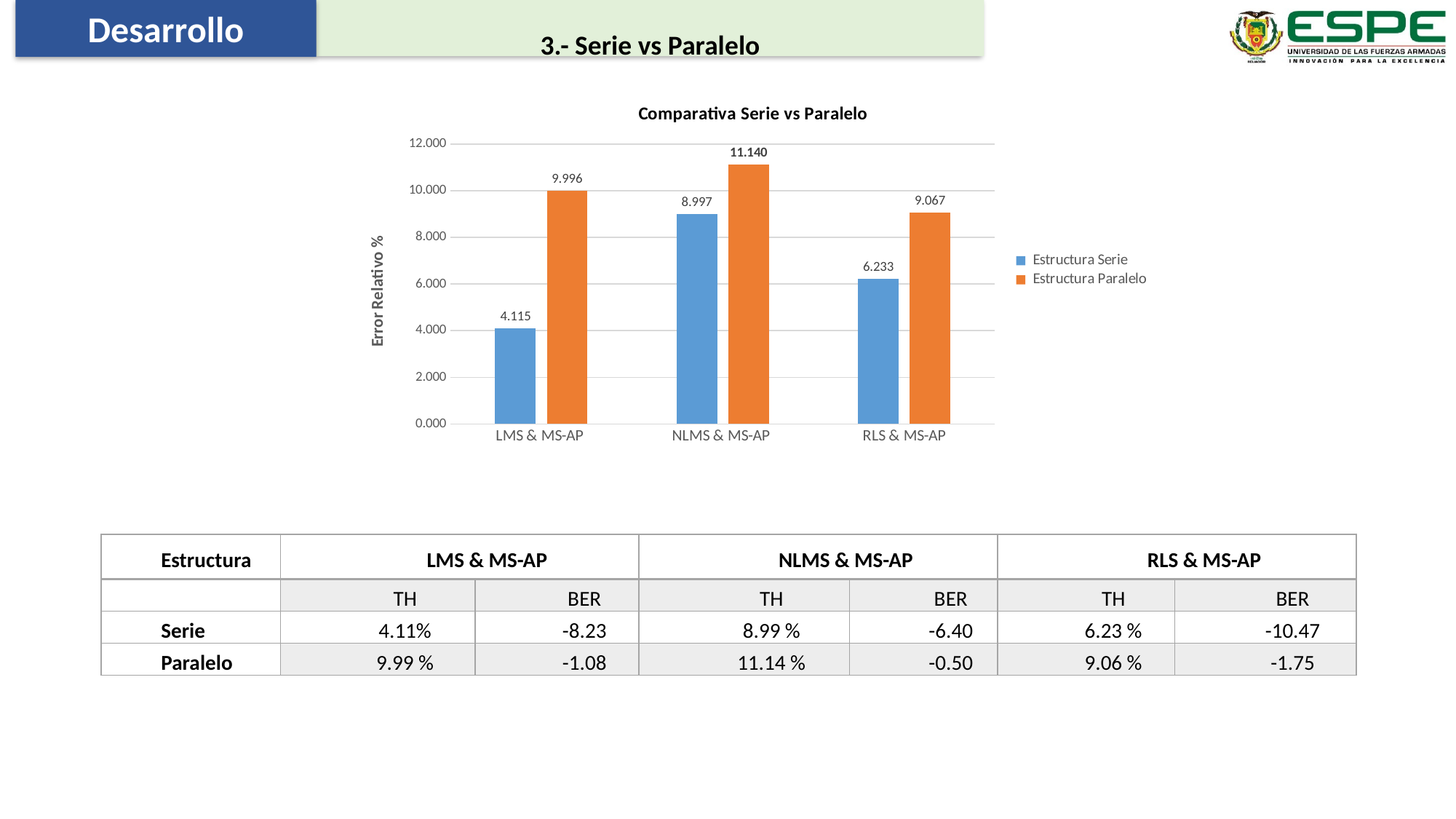
What is the difference between Estructura Paralelo and Estructura Serie for NLMS & MS-AP? 2.143 What is the value of Estructura Paralelo for RLS & MS-AP? 9.067 How many series does the legend list? 2 Which category has the highest Estructura Serie value? NLMS & MS-AP What is the title of the chart? Comparativa Serie vs Paralelo Which is larger for RLS & MS-AP, Estructura Serie or Estructura Paralelo? Estructura Paralelo What kind of chart is shown? Bar chart How many categories are shown on the x axis? 3 What is the value of Estructura Paralelo for NLMS & MS-AP? 11.140 What is the value of Estructura Serie for LMS & MS-AP? 4.115 Which category has the lowest Estructura Paralelo value? RLS & MS-AP What is the difference between Estructura Paralelo and Estructura Serie for LMS & MS-AP? 5.881